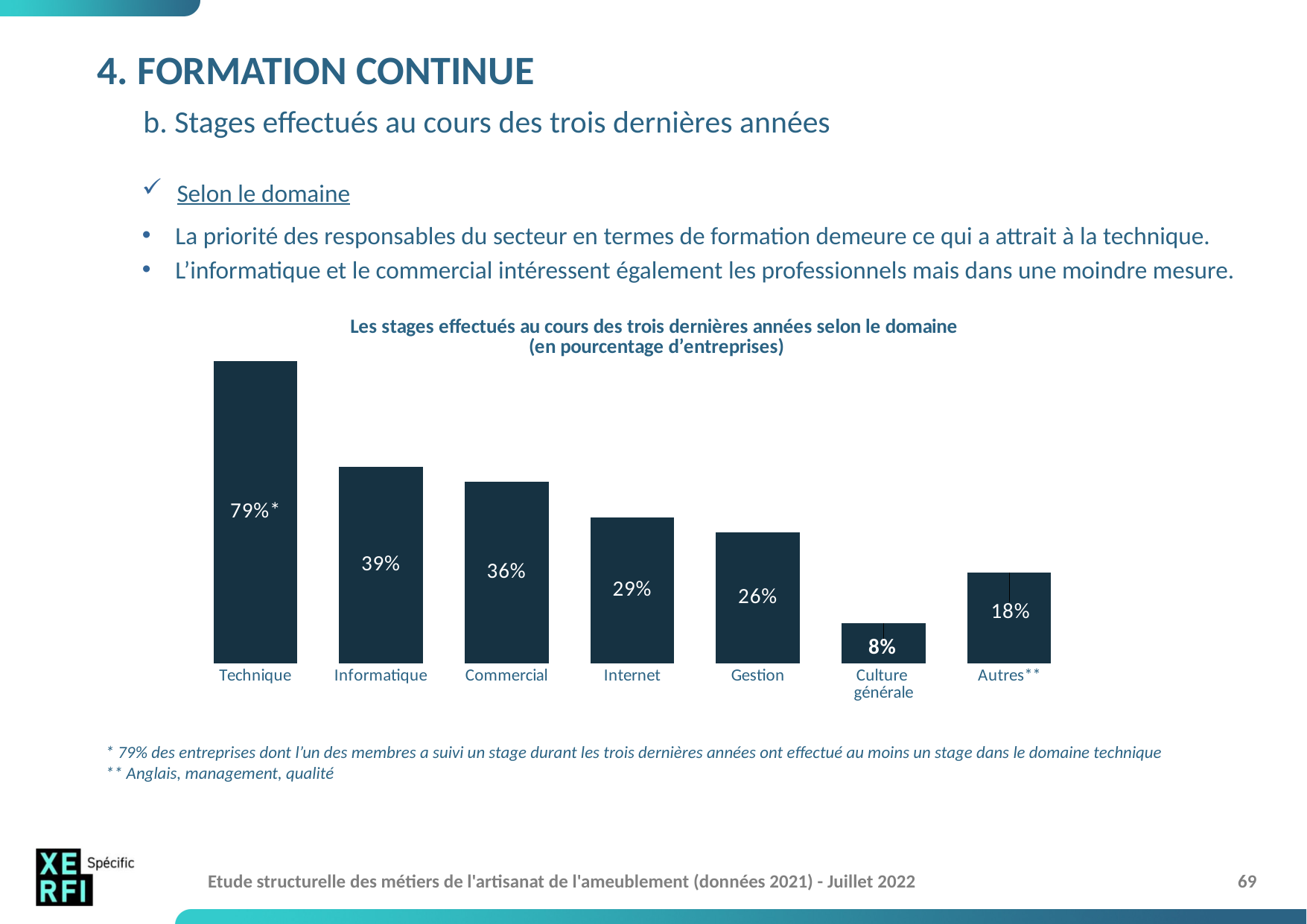
What is the value for Informatique? 39% Which category has the highest value? Technique What kind of chart is shown on the slide? Bar chart Which is larger, the value for Internet or the value for Autres? Internet What is the difference between the values for Commercial and Internet? 7% Which category has the lowest value? Culture générale What is the value for Autres? 18% What is the value for Technique? 79% What is the difference between the values for Technique and Informatique? 40% What is the value for Gestion? 26% What is the title of the chart? Les stages effectués au cours des trois dernières années selon le domaine (en pourcentage d'entreprises) How many categories are shown in the chart? 7